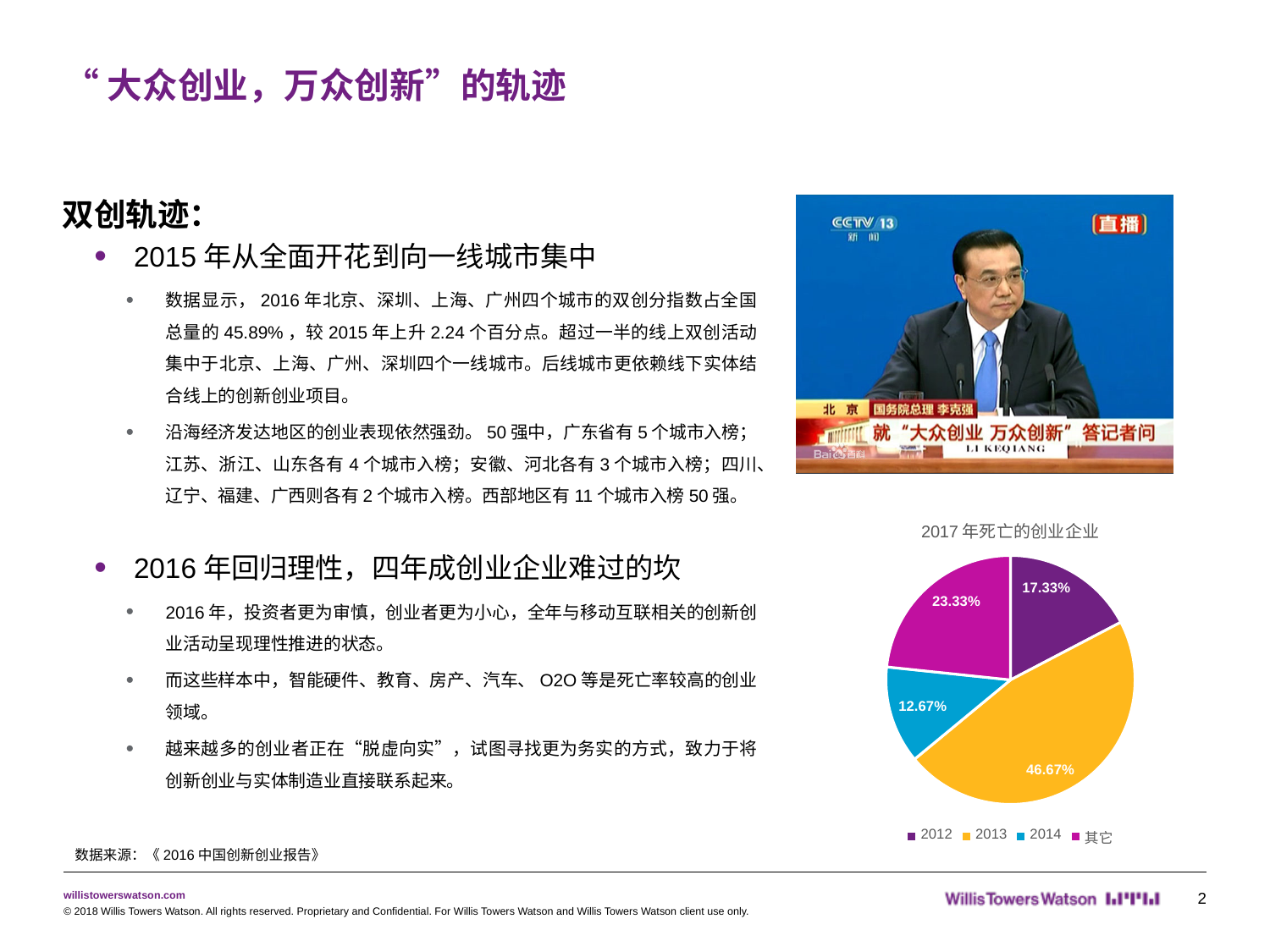
Which category has the largest slice of the pie? 2013 What share of the pie does 2012 account for? 17.33% What is the difference between the shares for 2013 and 2012? 29.34% What share of the pie does 2014 account for? 12.67% Which category has the smallest slice of the pie? 2014 What is the title of the pie chart? 2017 年死亡的创业企业 What kind of chart is shown on the slide? Pie chart How many entries does the legend list? 4 What share of the pie does 2013 account for? 46.67% What share of the pie does 其它 account for? 23.33% How many slices does the pie chart have? 4 Which is larger, the share for 其它 or the share for 2012? 其它